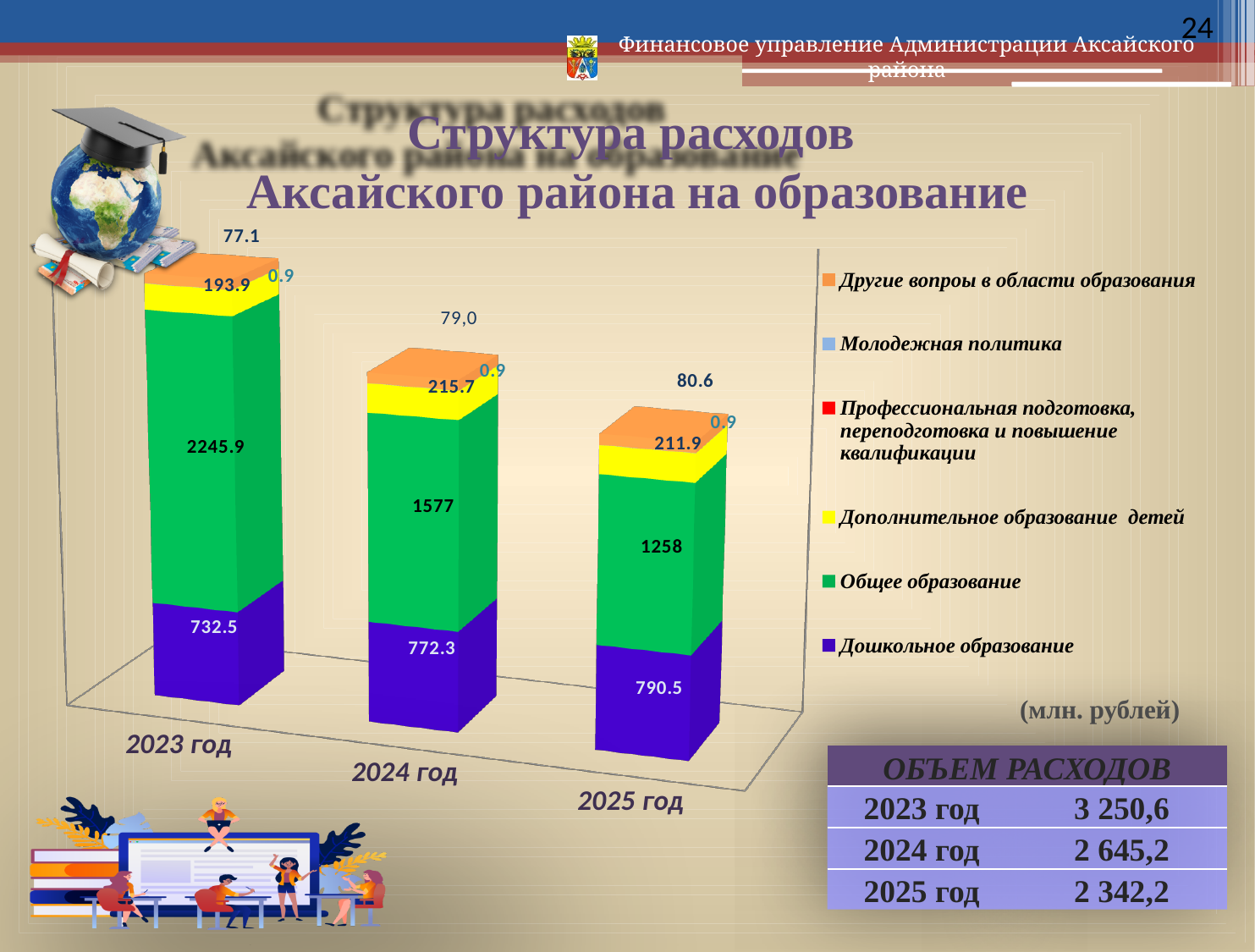
Which year has the larger value for Дошкольное образование, 2024 год or 2025 год? 2025 год In which year is the value for Дошкольное образование the lowest? 2023 год What is the difference between the Общее образование values for 2023 год and 2025 год? 987.9 What is the difference between the Дошкольное образование values for 2024 год and 2023 год? 39.8 What is the value for Дошкольное образование in 2025 год? 790.5 What is the value for Общее образование in 2023 год? 2245.9 How many series does the legend list? 6 In which year is the value for Общее образование the highest? 2023 год What is the value for Дополнительное образование детей in 2024 год? 215.7 What is the value for Другие вопросы в области образования in 2025 год? 80.6 How many years are shown on the x axis of the chart? 3 What kind of chart is shown on the slide? stacked bar chart